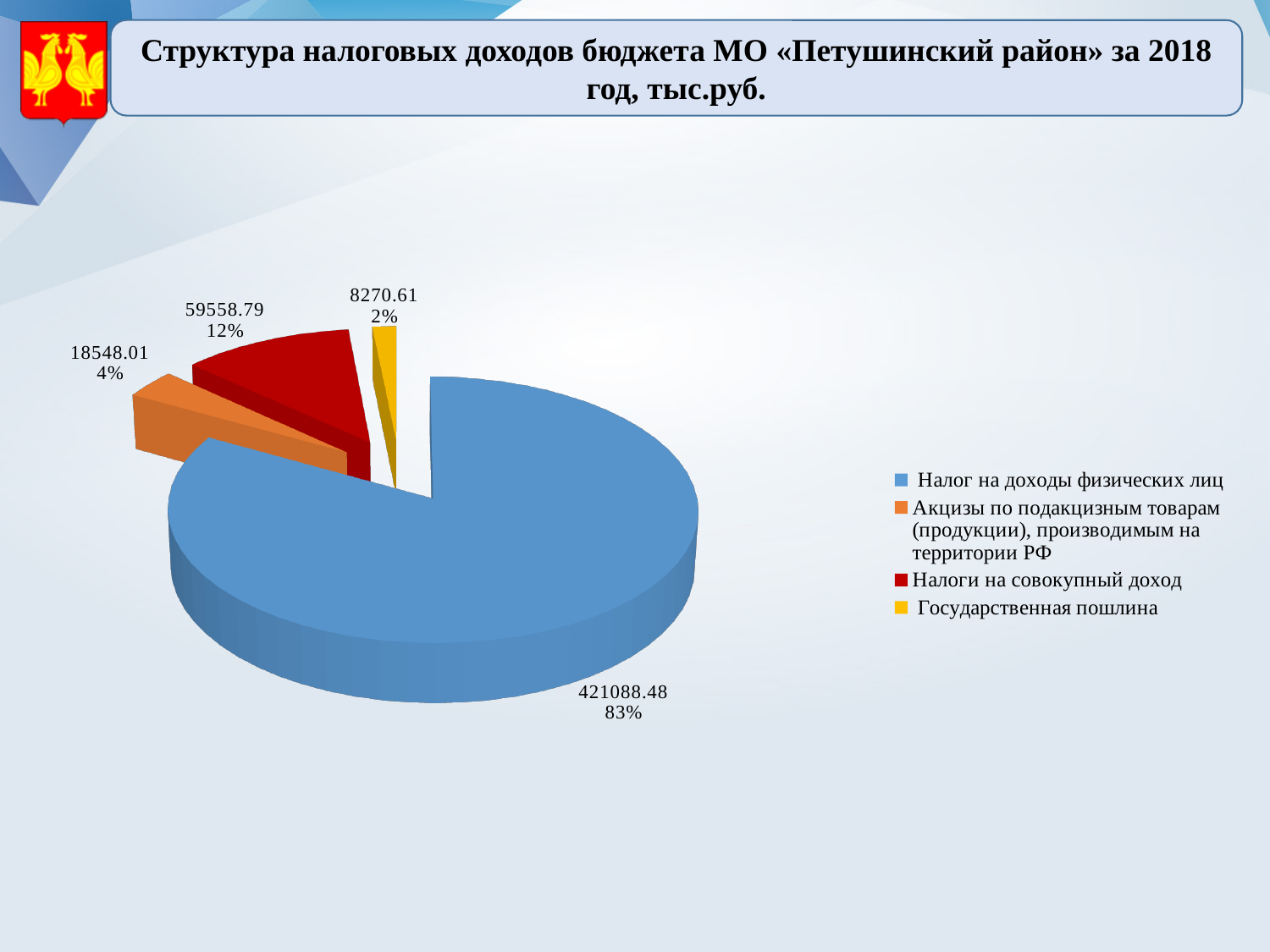
Which is larger: the value for Налоги на совокупный доход or the value for Государственная пошлина? Налоги на совокупный доход Which category has the smallest share of the pie? Государственная пошлина What is the difference between the values for Налоги на совокупный доход and Акцизы по подакцизным товарам (продукции), производимым на территории РФ? 41010.78 What is the value for Акцизы по подакцизным товарам (продукции), производимым на территории РФ? 18548.01 How many categories does the pie chart show? 4 What share of the pie does Акцизы по подакцизным товарам (продукции), производимым на территории РФ represent? 4% What is the value for Налог на доходы физических лиц? 421088.48 Which category has the largest share of the pie? Налог на доходы физических лиц What type of chart is shown on the slide? Pie chart What share of the pie does Налоги на совокупный доход represent? 12% What is the value for Государственная пошлина? 8270.61 What is the value for Налоги на совокупный доход? 59558.79